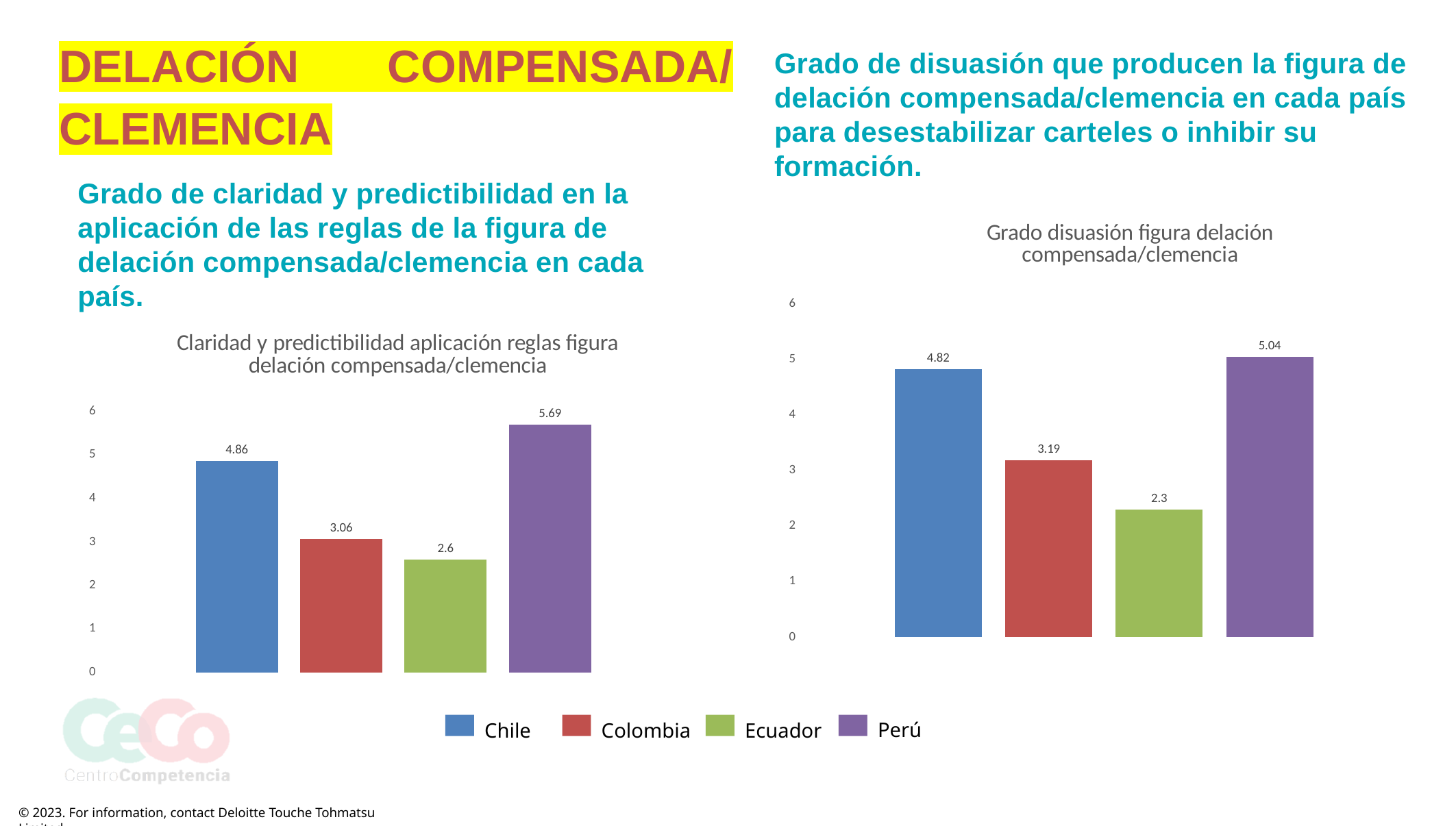
In the right chart (Grado disuasión figura delación compensada/clemencia), what is the value for Colombia? 3.19 In the right chart (Grado disuasión figura delación compensada/clemencia), what is the value for Perú? 5.04 In the left chart (Claridad y predictibilidad aplicación reglas figura delación compensada/clemencia), which country has the highest value? Perú In the right chart (Grado disuasión figura delación compensada/clemencia), which country has the lowest value? Ecuador What type of chart is the right chart (Grado disuasión figura delación compensada/clemencia)? Bar chart In the right chart (Grado disuasión figura delación compensada/clemencia), what is the difference between Chile and Ecuador? 2.52 In the left chart (Claridad y predictibilidad aplicación reglas figura delación compensada/clemencia), what is the value for Ecuador? 2.6 In the right chart (Grado disuasión figura delación compensada/clemencia), which is larger, the value for Chile or the value for Colombia? Chile In the left chart (Claridad y predictibilidad aplicación reglas figura delación compensada/clemencia), what is the difference between Perú and Colombia? 2.63 In the left chart (Claridad y predictibilidad aplicación reglas figura delación compensada/clemencia), what is the value for Chile? 4.86 How many countries are shown in the left chart (Claridad y predictibilidad aplicación reglas figura delación compensada/clemencia)? 4 Which country does the green colour represent in the legend? Ecuador